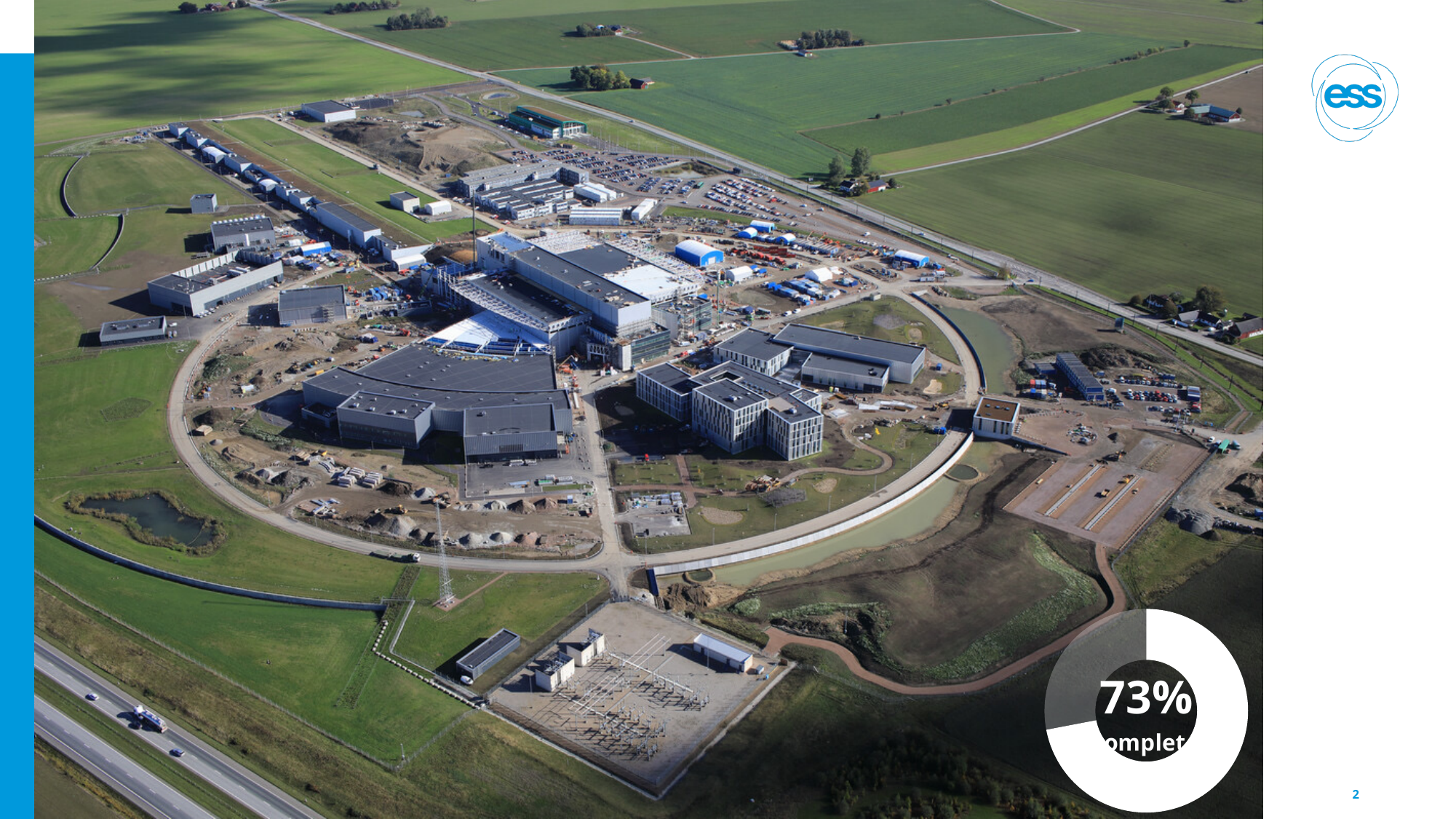
In the doughnut chart, which slice is larger: the white slice or the dark grey slice? the white slice If the doughnut chart shows 73% complete, what share of the chart is the remaining (dark grey) slice? 27% What percentage value is printed in the centre of the doughnut chart in the bottom-right corner of the slide? 73% Where on the slide is the doughnut chart located? bottom-right corner What colour is the larger slice of the doughnut chart? white Is the completed share shown in the doughnut chart greater or less than 50%? greater How many slices does the doughnut chart in the bottom-right corner have? 2 What kind of chart is shown in the bottom-right corner of the slide? doughnut (pie) chart